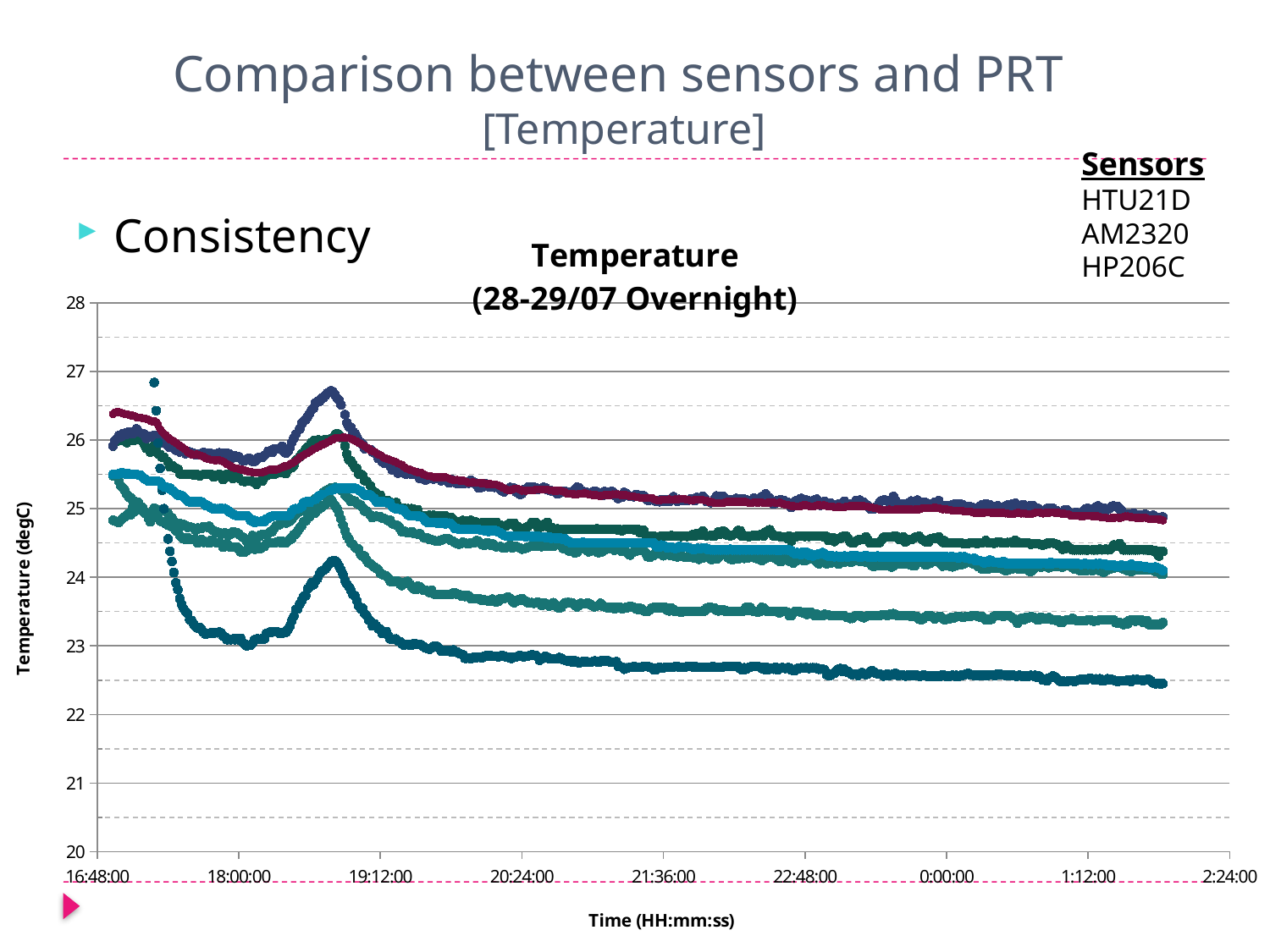
Do the plotted temperature values generally rise or fall from left to right after the peak near 19:00? fall Is the value of the highest plotted series at its peak near 19:00 greater or less than 26? greater What is the title of the chart? Temperature (28-29/07 Overnight) Is the value of the lowest plotted series at its peak near 19:00 greater or less than 25? less What is the label on the vertical axis of the chart? Temperature (degC) What kind of chart is shown on the slide? scatter chart Is the value of the highest plotted series at the right-hand end of the chart greater or less than 24? greater